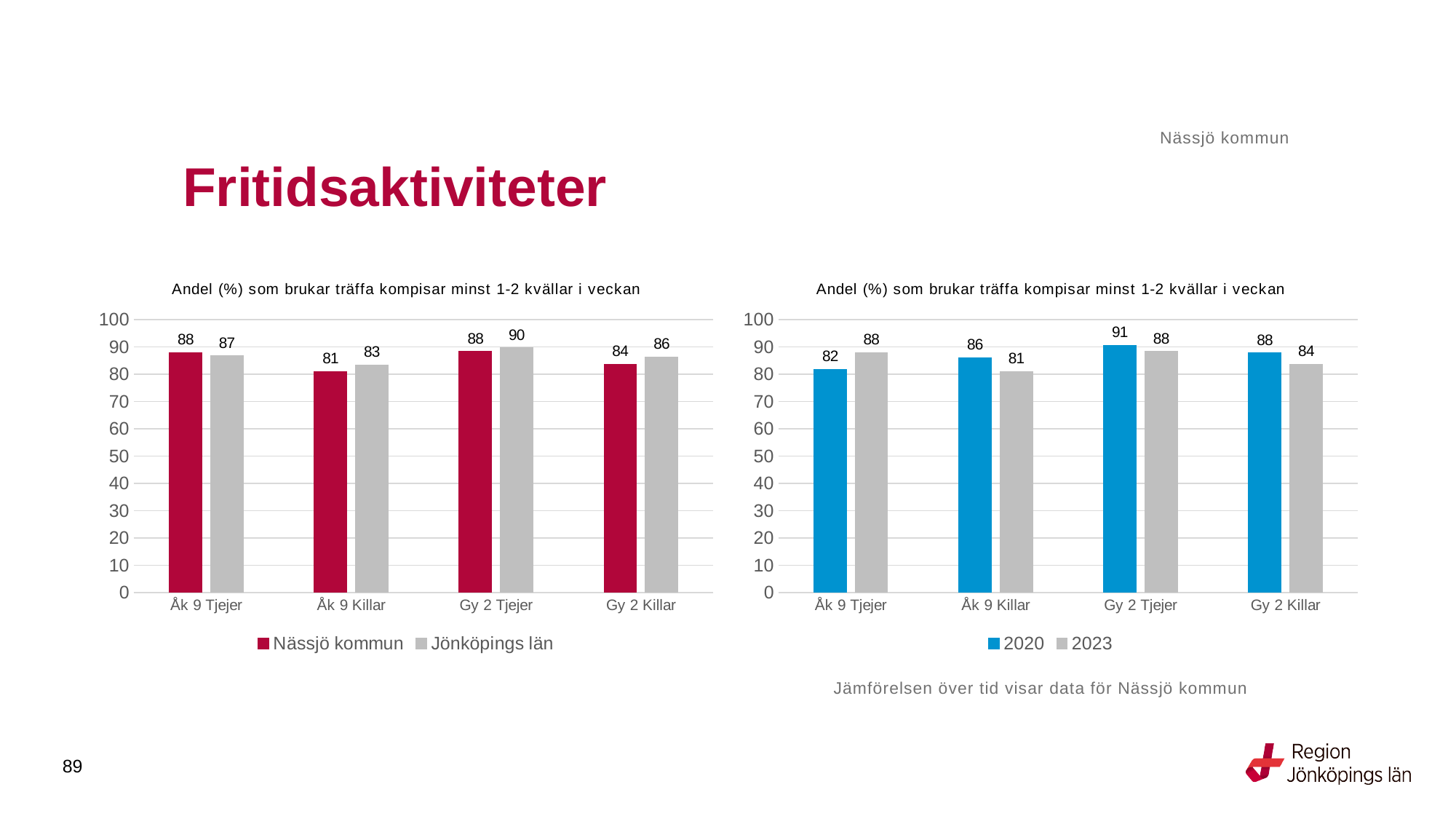
In the right chart, which is larger for Åk 9 Killar: the 2020 value or the 2023 value? 2020 In the left chart, what is the difference between Jönköpings län and Nässjö kommun for Gy 2 Killar? 2 How many categories are shown on the x axis of the left chart? 4 How many series does the legend of the right chart list? 2 In the right chart, what is the difference between the 2020 and 2023 values for Åk 9 Tjejer? 6 What type of chart is the left chart? Bar chart In the left chart, what is the value for Jönköpings län for Gy 2 Tjejer? 90 In the right chart, which category has the highest 2020 value? Gy 2 Tjejer In the right chart, what is the 2020 value for Gy 2 Tjejer? 91 In the left chart, which category has the lowest value for Nässjö kommun? Åk 9 Killar In the right chart, what is the 2023 value for Åk 9 Tjejer? 88 In the left chart, what is the value for Nässjö kommun for Åk 9 Killar? 81